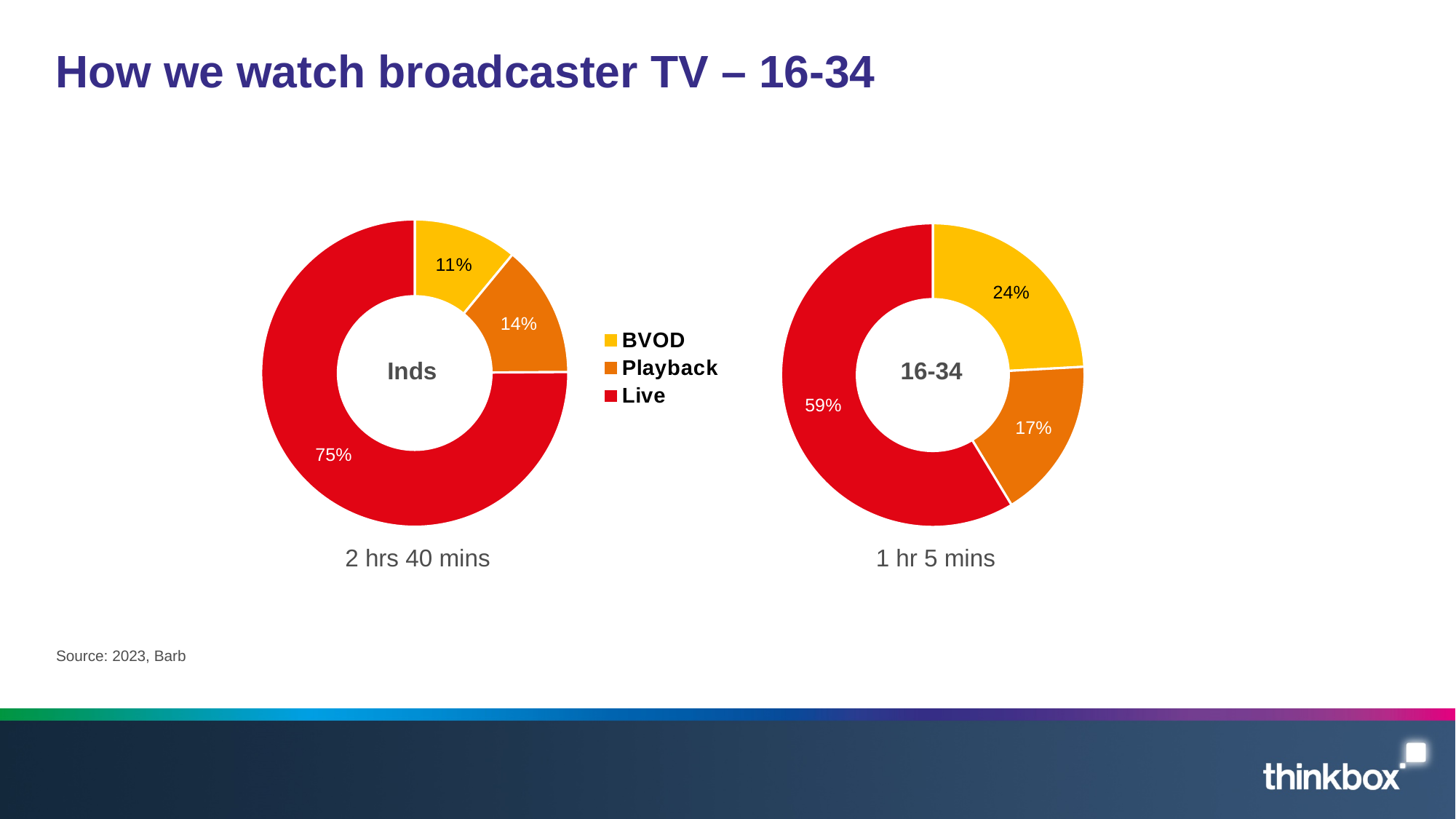
What viewing time is shown below the 16-34 donut chart? 1 hr 5 mins In the Inds donut chart, what share is Live? 75% Which colour represents Playback in the legend? Orange What is the difference between the Live share in the Inds chart and the Live share in the 16-34 chart? 16 percentage points In the 16-34 donut chart, what share is Playback? 17% In the Inds donut chart, what share is BVOD? 11% What type of chart is used on this slide? Donut (pie) chart How many categories does the legend list? 3 In the 16-34 donut chart, what share is BVOD? 24% In the 16-34 donut chart, which category has the smallest share? Playback In the Inds donut chart, which category has the largest share? Live Is the BVOD share larger in the Inds chart or the 16-34 chart? 16-34